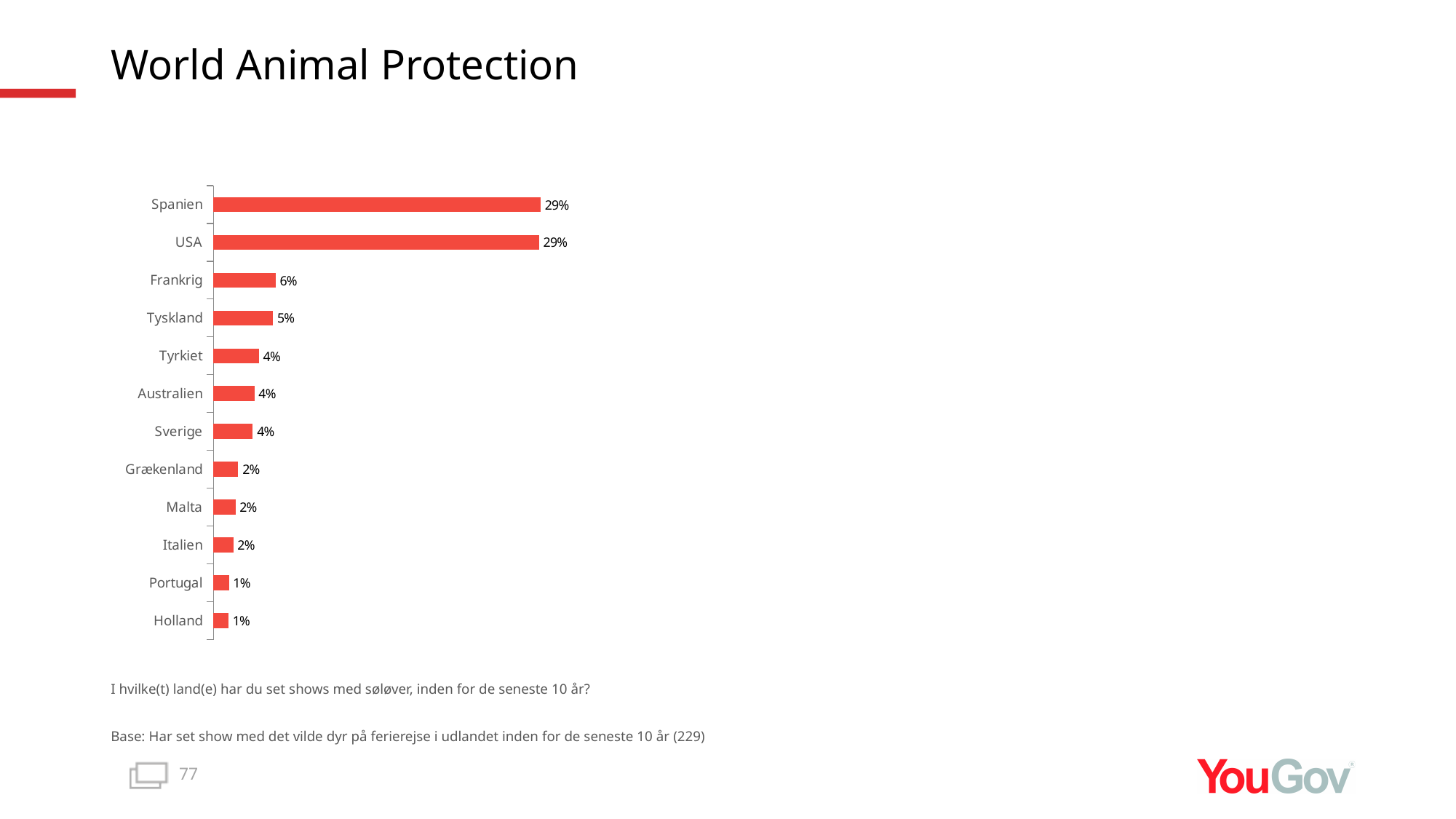
What colour are the bars in the chart? Red Which has a larger value, Frankrig or Tyrkiet? Frankrig What is the value for Grækenland? 2% What is the highest value shown in the chart? 29% What is the value for Spanien? 29% How many countries are shown in the chart? 12 What is the value for Holland? 1% What is the value for Tyskland? 5% What kind of chart is shown on the slide? Bar chart What is the difference between the values for Tyskland and Malta? 3% What is the difference between the values for USA and Frankrig? 23% What is the value for Frankrig? 6%